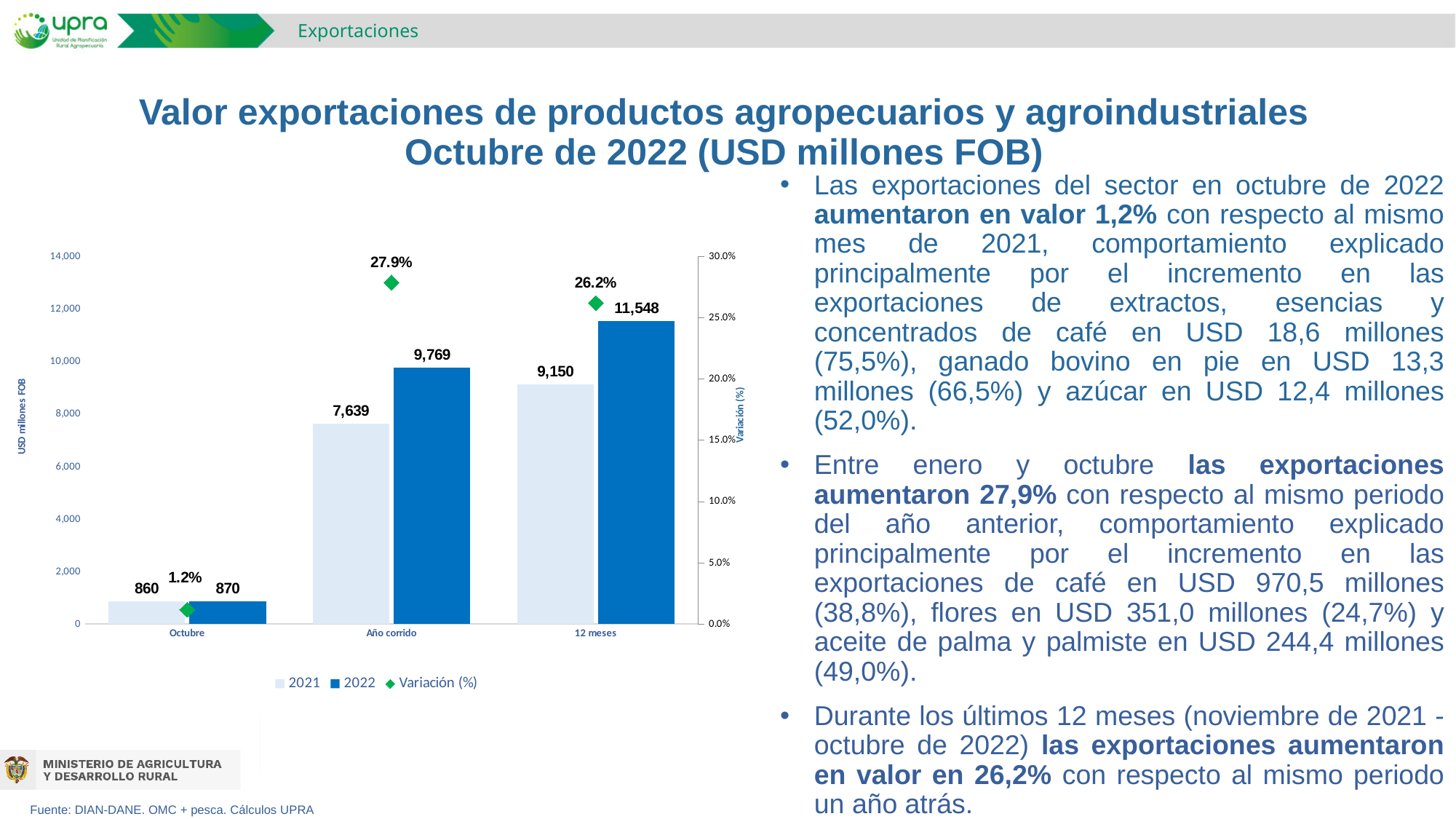
Which category has the lowest Variación (%) value? Octubre What is the 2021 value for 12 meses? 9,150 How many categories are shown on the x axis? 3 What is the Variación (%) value for Octubre? 1.2% Which category has the highest 2022 value? 12 meses Which is larger, the 2021 value for 12 meses or the 2022 value for Año corrido? 2022 value for Año corrido What kind of chart is shown on the slide? Bar chart with a line/marker series What is the 2022 value for Año corrido? 9,769 How many series does the legend list? 3 What is the difference between the 2022 and 2021 values for 12 meses? 2,398 What is the difference between the 2022 and 2021 values for Año corrido? 2,130 What is the label of the left vertical axis? USD millones FOB